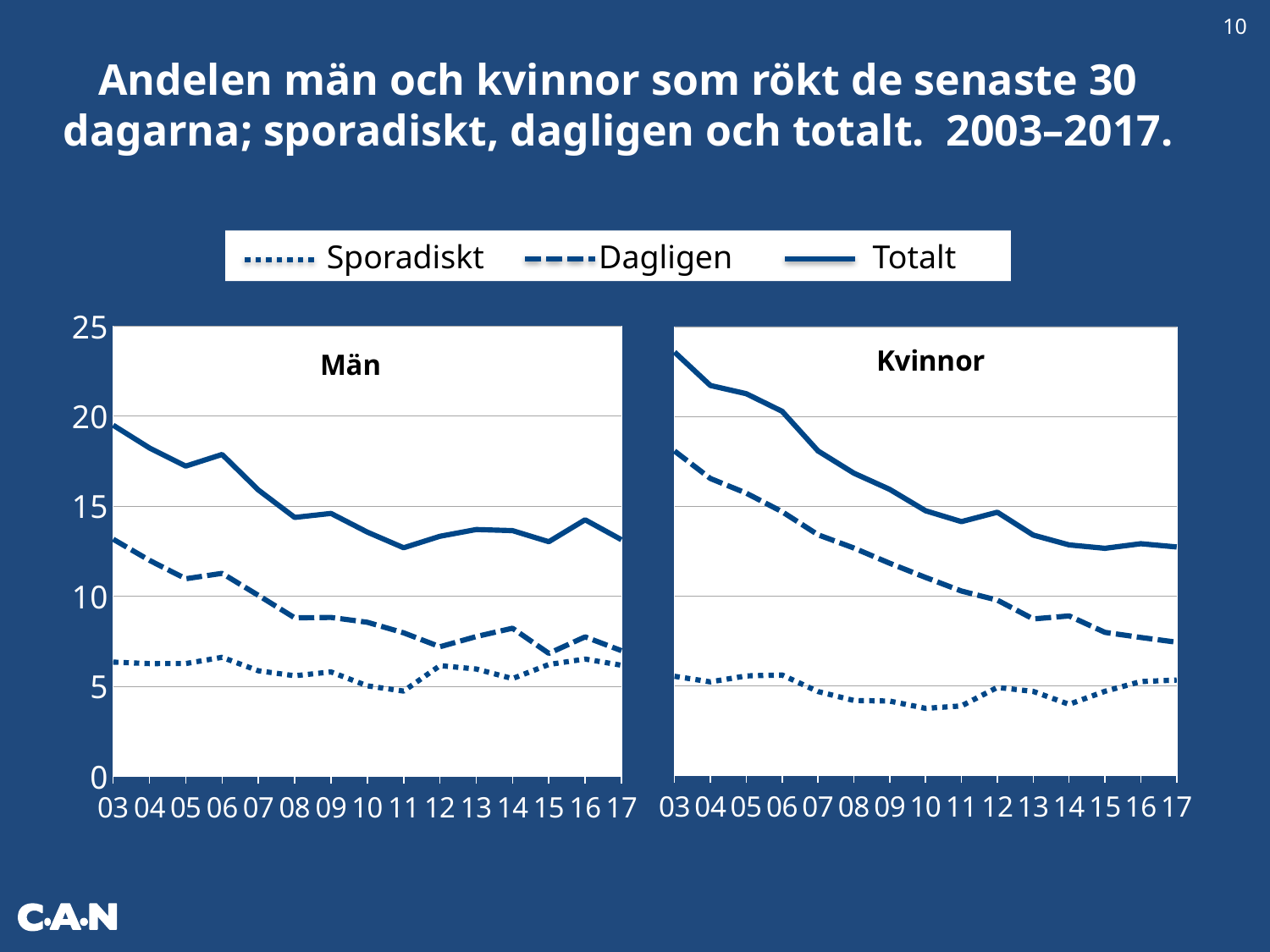
In the Kvinnor chart, is the Sporadiskt value for 10 greater or less than 5? less In the Män chart, how many years are shown on the x axis? 15 In the Kvinnor chart, is the Totalt value for 03 greater or less than 20? greater In the Kvinnor chart, does the Totalt line rise or fall from 03 to 17? fall In the Män chart, in which year is the Totalt value highest? 03 How many series does the legend list? 3 In the Män chart, is the Dagligen value for 17 greater or less than 10? less Which is larger for 03: the Totalt value in the Män chart or the Totalt value in the Kvinnor chart? Kvinnor What kind of chart is used on this slide for Män and Kvinnor? line chart Which line style does the legend use for Sporadiskt? dotted